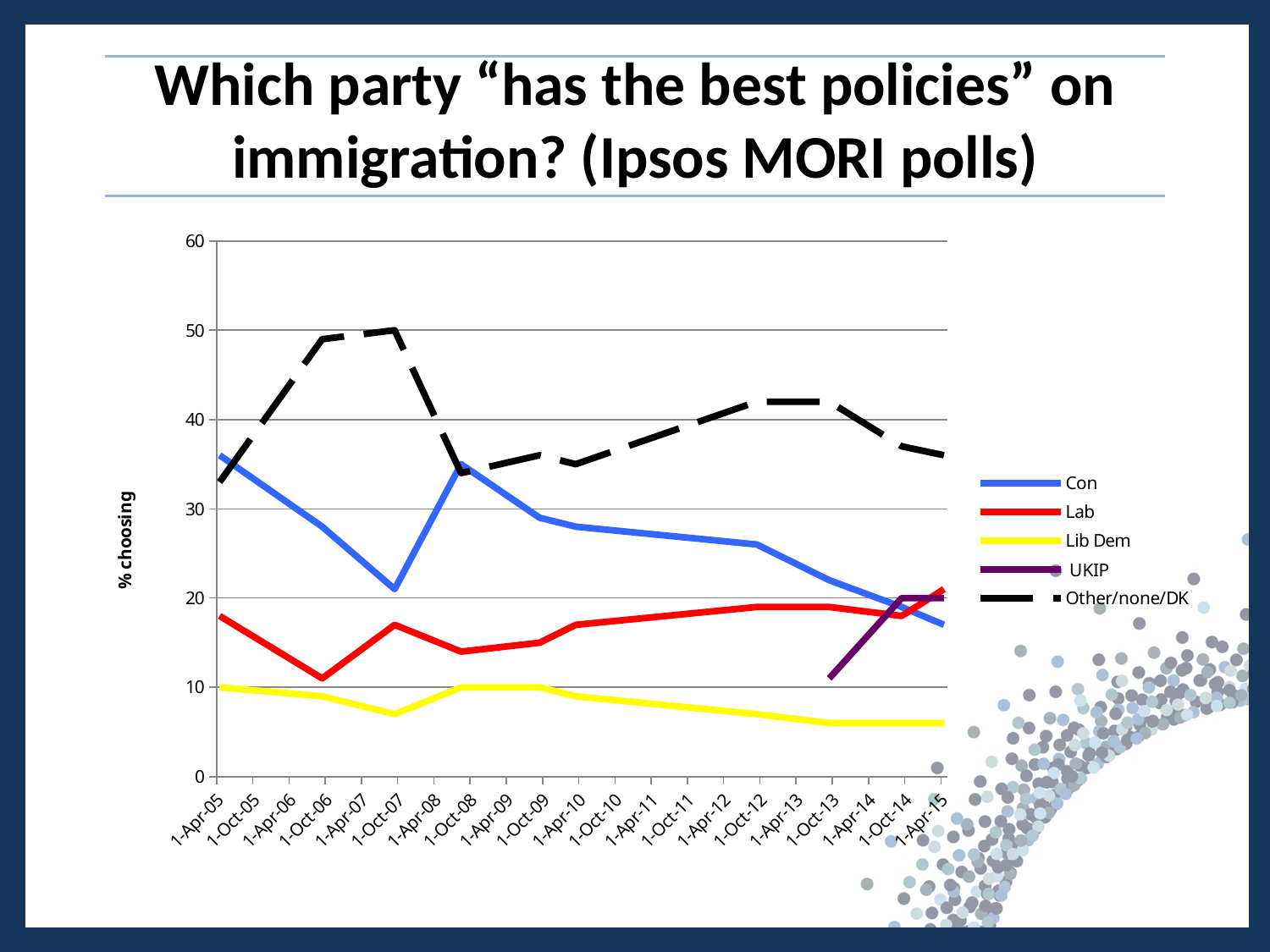
Which series has the highest value at 1-Apr-15? Other/none/DK What is the label on the vertical axis? % choosing Is the value for Lab at 1-Oct-06 greater or less than 20? less Is the value for Other/none/DK at 1-Oct-07 greater or less than 40? greater Does the Con line rise or fall overall from 1-Apr-05 to 1-Apr-15? Fall How many dates are labelled along the x axis? 21 Which series is drawn as a dashed black line? Other/none/DK What kind of chart is shown on the slide? Line chart Is the value for Lib Dem at 1-Apr-15 greater or less than 10? less Which series has the lowest value at 1-Apr-05? Lib Dem How many series does the legend list? 5